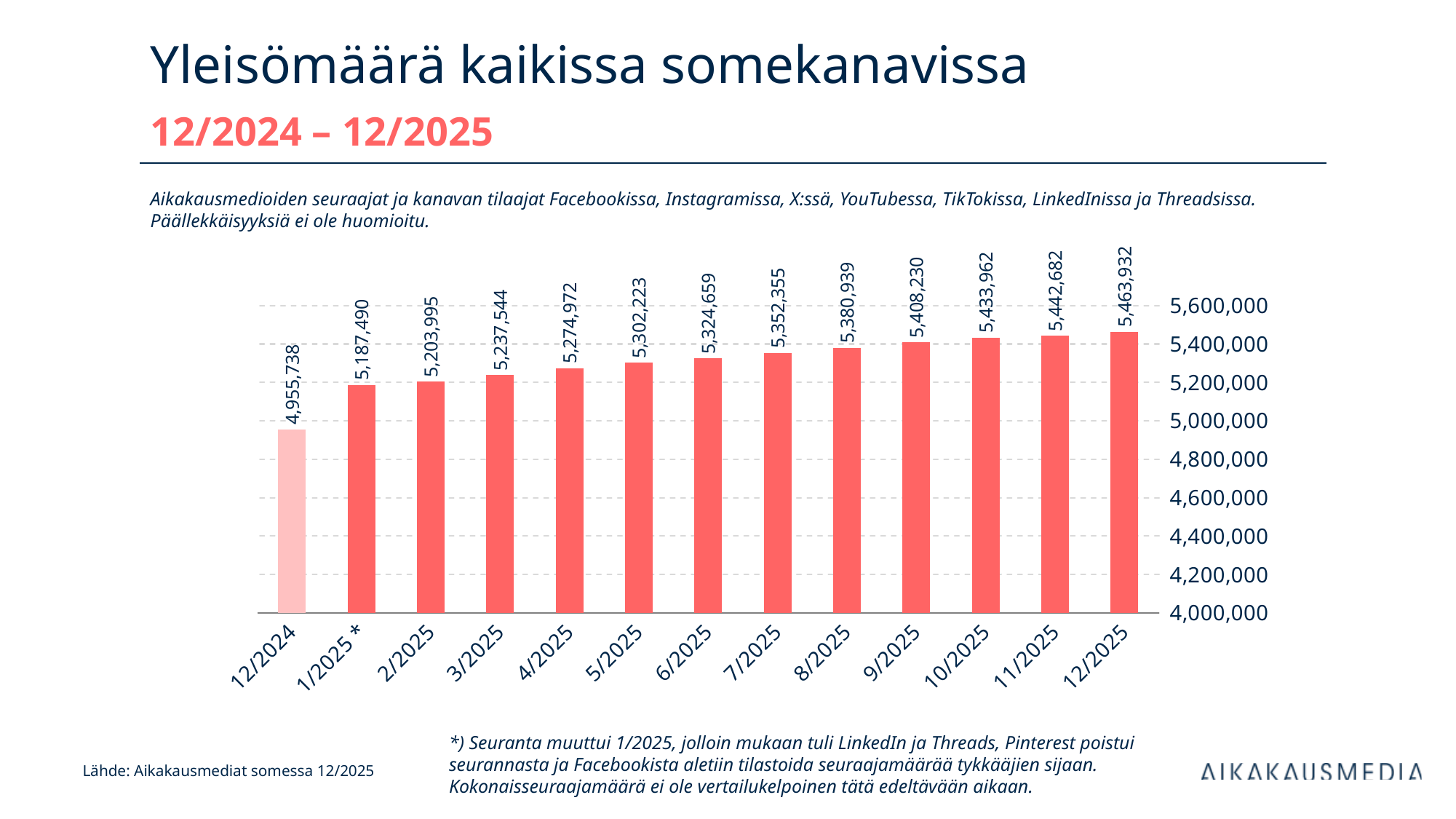
Which is larger, the value for 3/2025 or the value for 9/2025? 9/2025 What kind of chart is shown on the slide? Bar chart What is the value for 12/2025? 5,463,932 What is the difference between the values for 11/2025 and 10/2025? 8,720 What is the value for 12/2024? 4,955,738 Do the values rise or fall from 12/2024 to 12/2025? Rise What is the value for 1/2025 *? 5,187,490 How many months are shown on the x axis? 13 What is the value for 6/2025? 5,324,659 What is the difference between the values for 12/2025 and 12/2024? 508,194 Which month has the lowest value? 12/2024 Which month has the highest value? 12/2025